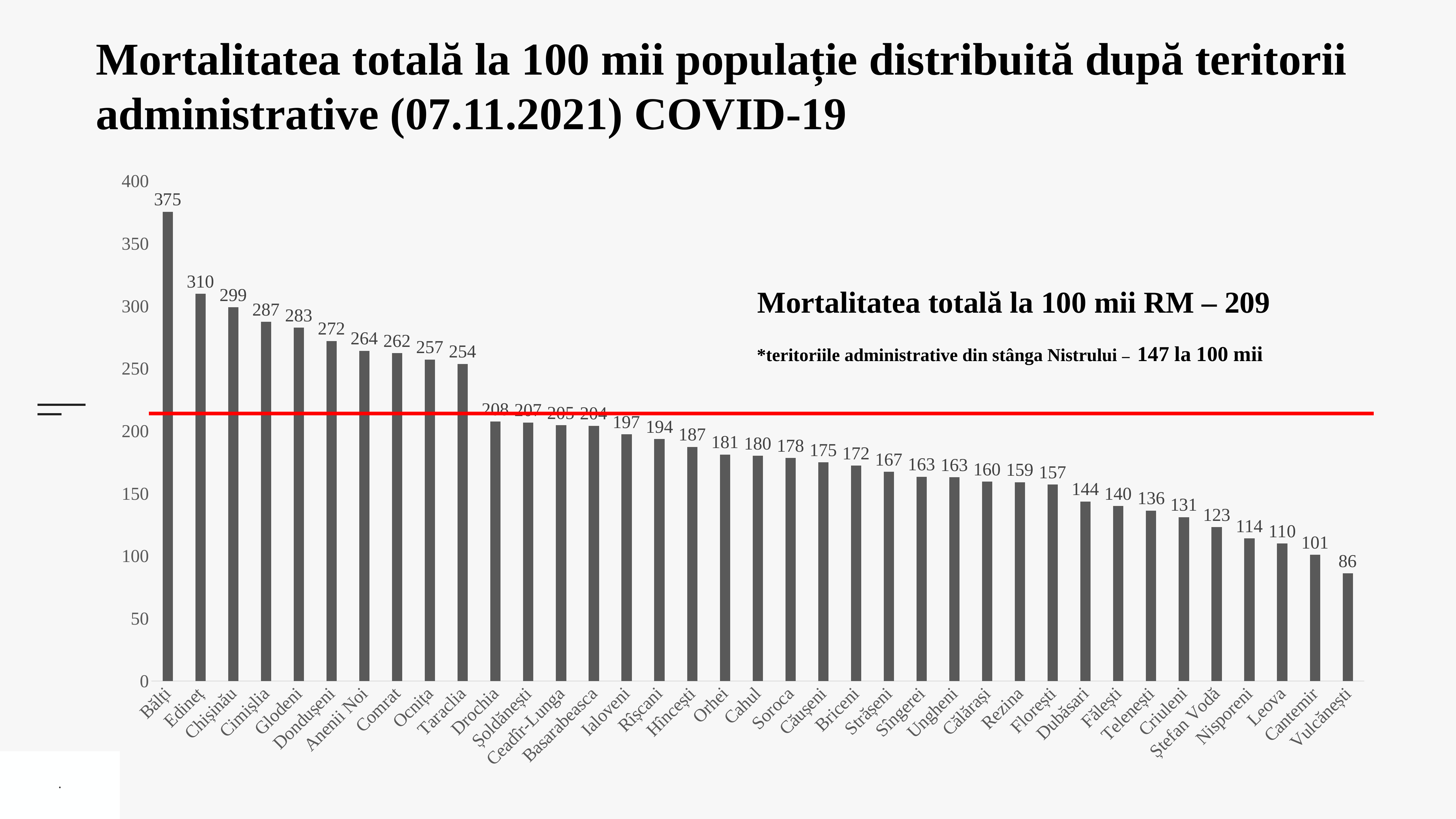
What is the value for Bălți? 375 What is the difference between the values for Bălți and Vulcănești? 289 What is the value for Ștefan Vodă? 123 Which has a larger value, Comrat or Orhei? Comrat Which territory has the lowest value? Vulcănești Which territory has the highest value? Bălți Do the values rise or fall from left to right along the x axis? fall Is the value for Glodeni greater or less than 250? greater What is the difference between the values for Edineț and Chișinău? 11 How many territories are shown on the chart? 37 What kind of chart is shown on the slide? bar chart What is the value for Cahul? 180